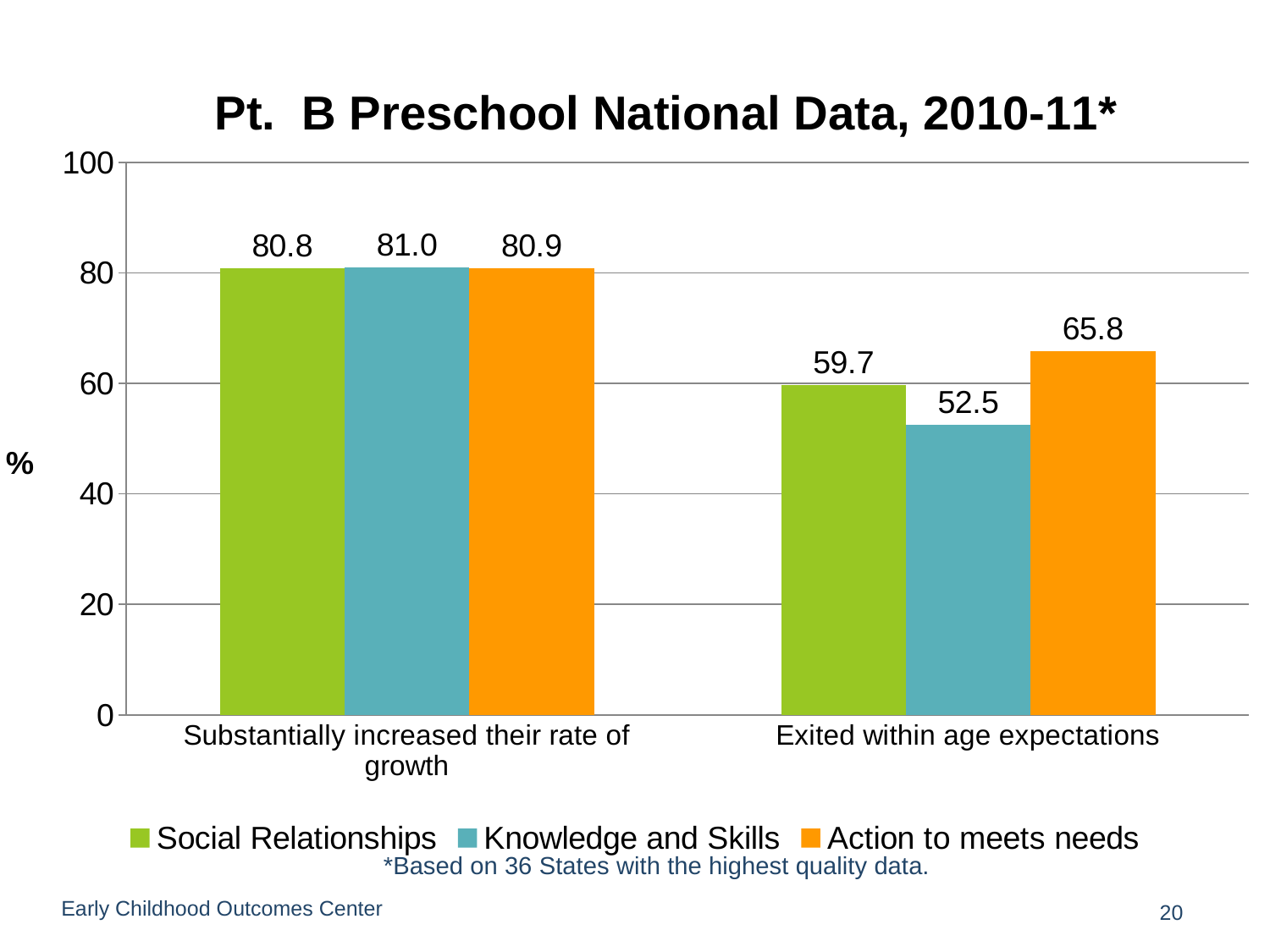
Is the value for Knowledge and Skills in 'Exited within age expectations' greater or less than 60? less What is the title of the chart? Pt. B Preschool National Data, 2010-11* What kind of chart is shown on the slide? bar chart What is the difference between the Social Relationships values for the two categories? 21.1 Which series has the highest value in the 'Exited within age expectations' category? Action to meets needs Is the Social Relationships value for 'Exited within age expectations' larger or smaller than the Knowledge and Skills value for the same category? larger What is the value for Social Relationships in the 'Substantially increased their rate of growth' category? 80.8 What is the value for Action to meets needs in the 'Exited within age expectations' category? 65.8 How many series does the legend list? 3 What is the value for Knowledge and Skills in the 'Exited within age expectations' category? 52.5 Which series has the lowest value in the 'Exited within age expectations' category? Knowledge and Skills What is the difference between the Action to meets needs value and the Knowledge and Skills value in the 'Exited within age expectations' category? 13.3